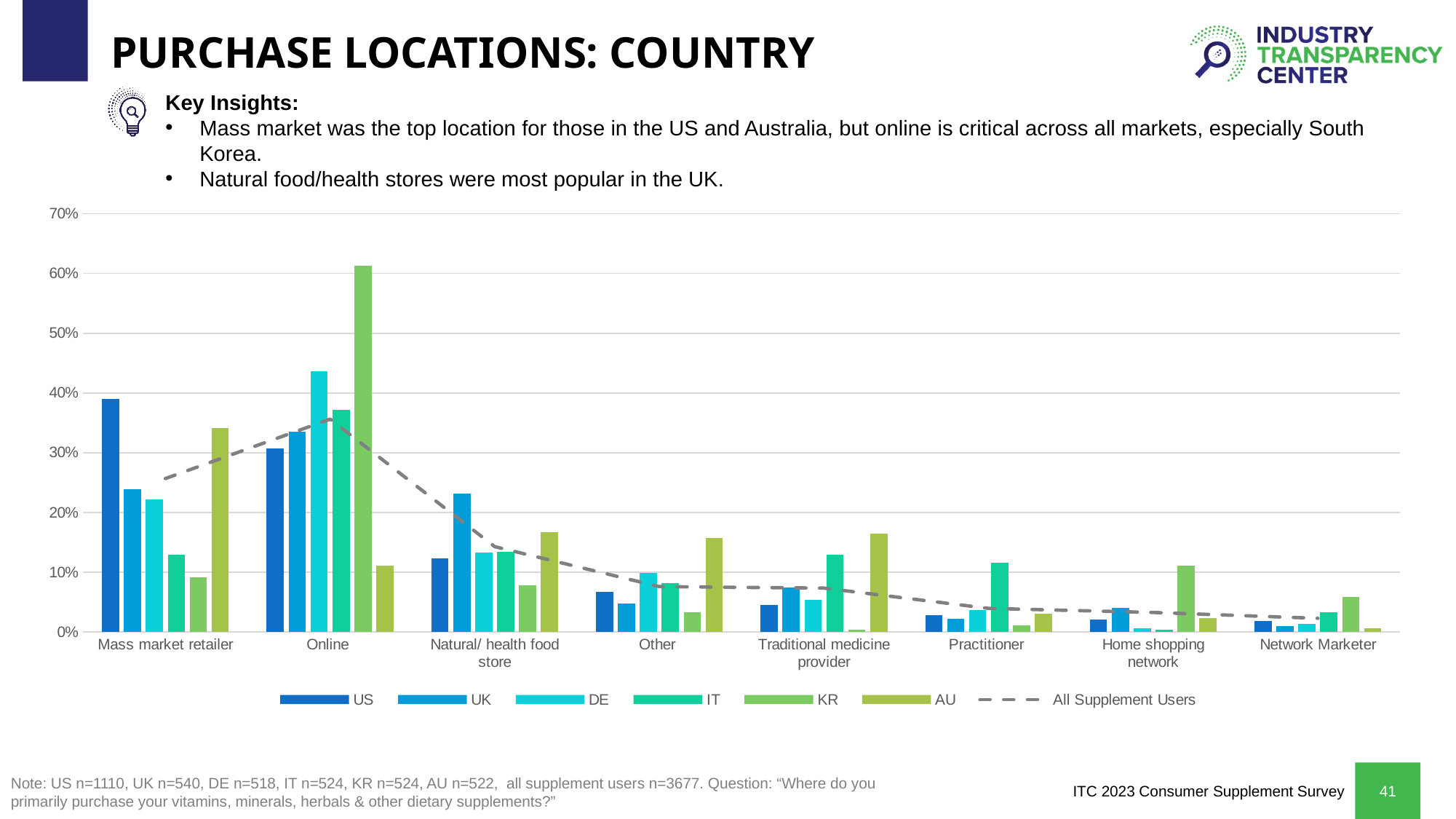
Which country has the highest value for Traditional medicine provider? AU How many entries does the legend list? 7 For Mass market retailer, which is larger, the US value or the AU value? US Is the value for AU at Online greater or less than 20%? less What does the dashed grey line represent? All Supplement Users Which country has the highest value for Mass market retailer? US Which country has the lowest value for Mass market retailer? KR How many purchase location categories are shown on the x axis? 8 Which country has the highest value for Online? KR Is the value for KR at Online greater or less than 50%? greater What kind of chart is shown on the slide? combination bar and line chart